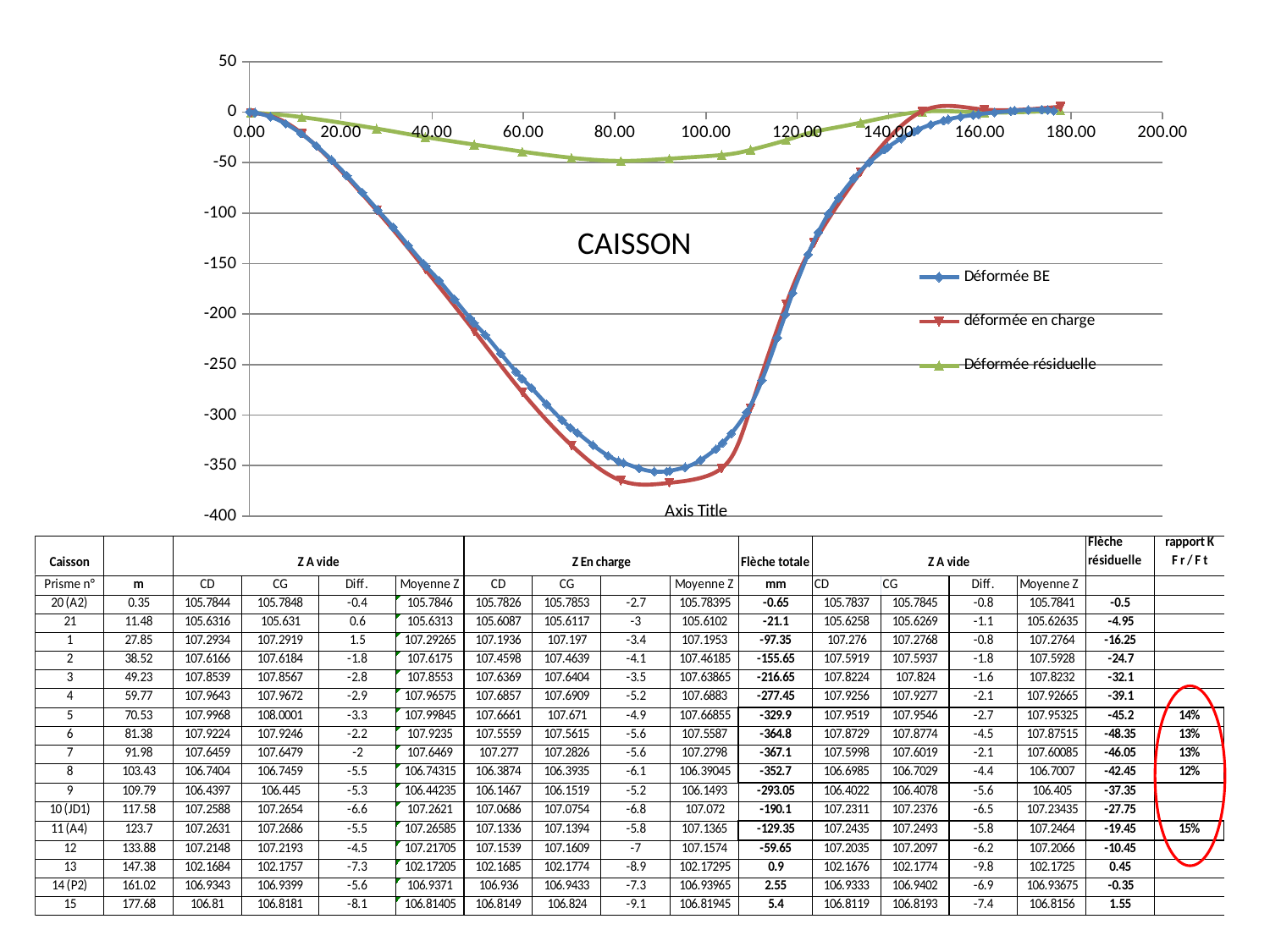
Which series reaches the lowest value on the chart? déformée en charge Is the value of Déformée résiduelle at 120.00 greater or less than -50? greater Does the déformée en charge series rise or fall between 100.00 and 160.00 on the x axis? rise Does the Déformée BE series rise or fall between 0.00 and 80.00 on the x axis? fall Is the value of Déformée BE at 40.00 greater or less than -100? less How many series does the chart legend list? 3 What kind of chart is shown on the slide? line chart Is the value of Déformée résiduelle at 80.00 greater or less than -100? greater Which series is drawn in green in the chart? Déformée résiduelle At 80.00, which series has the lower value: déformée en charge or Déformée résiduelle? déformée en charge What is the title shown on the chart? CAISSON